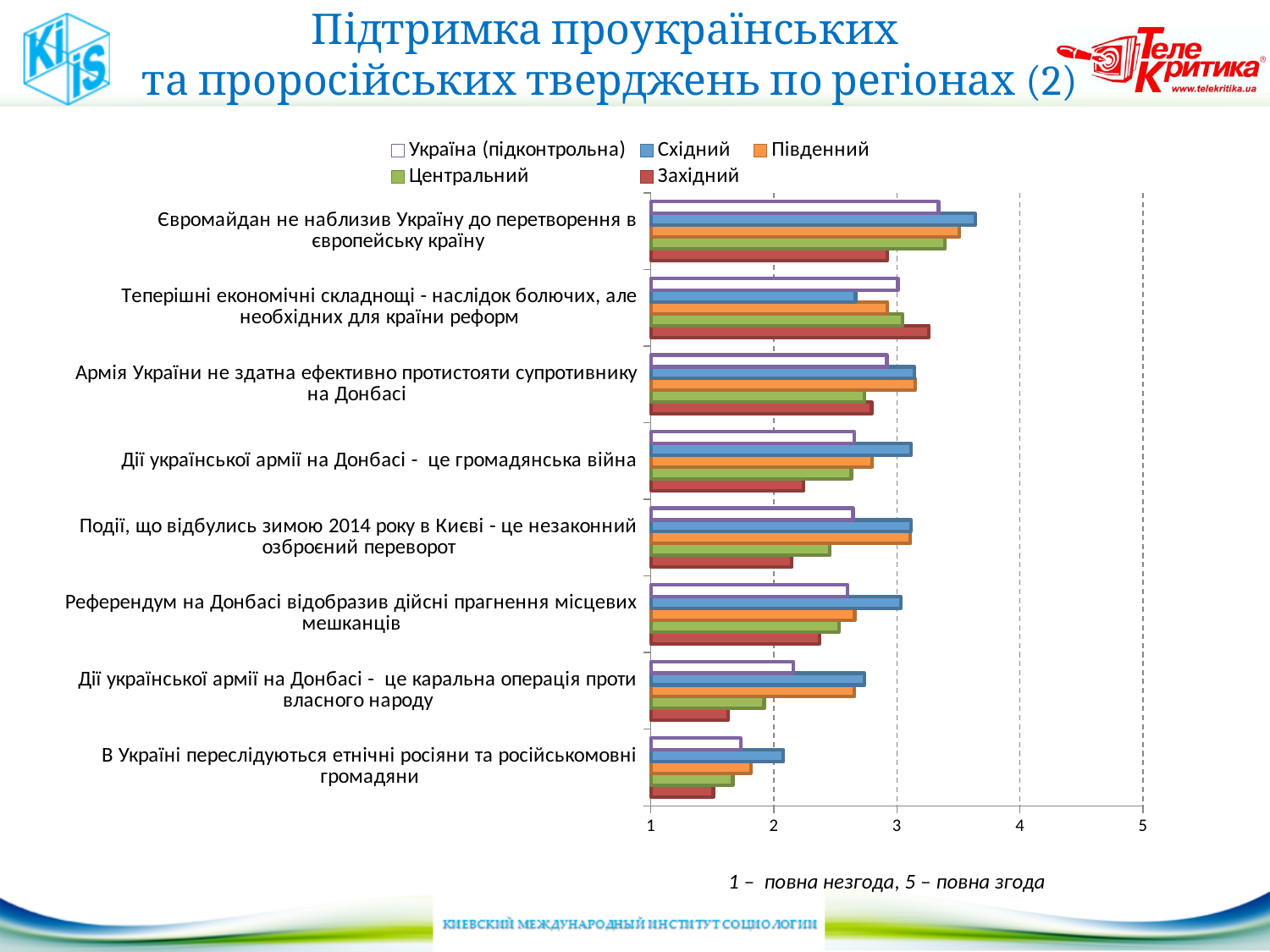
How many series does the legend list? 5 For the statement "Євромайдан не наблизив Україну до перетворення в європейську країну", which is larger: the value for Східний or for Західний? Східний According to the note under the chart, what does a value of 5 mean? повна згода Is the value for Східний on the statement "Євромайдан не наблизив Україну до перетворення в європейську країну" greater or less than 3? greater What kind of chart is shown on the slide? bar chart Is the value for Східний on the statement "Дії української армії на Донбасі - це каральна операція проти власного народу" greater or less than 3? less For the statement "Євромайдан не наблизив Україну до перетворення в європейську країну", which region has the lowest value? Західний For the statement "В Україні переслідуються етнічні росіяни та російськомовні громадяни", which region has the highest value? Східний Is the value for Західний on the statement "В Україні переслідуються етнічні росіяни та російськомовні громадяни" greater or less than 2? less For the statement "Теперішні економічні складнощі - наслідок болючих, але необхідних для країни реформ", which is larger: the value for Західний or for Східний? Західний How many statements (categories) are plotted on the chart? 8